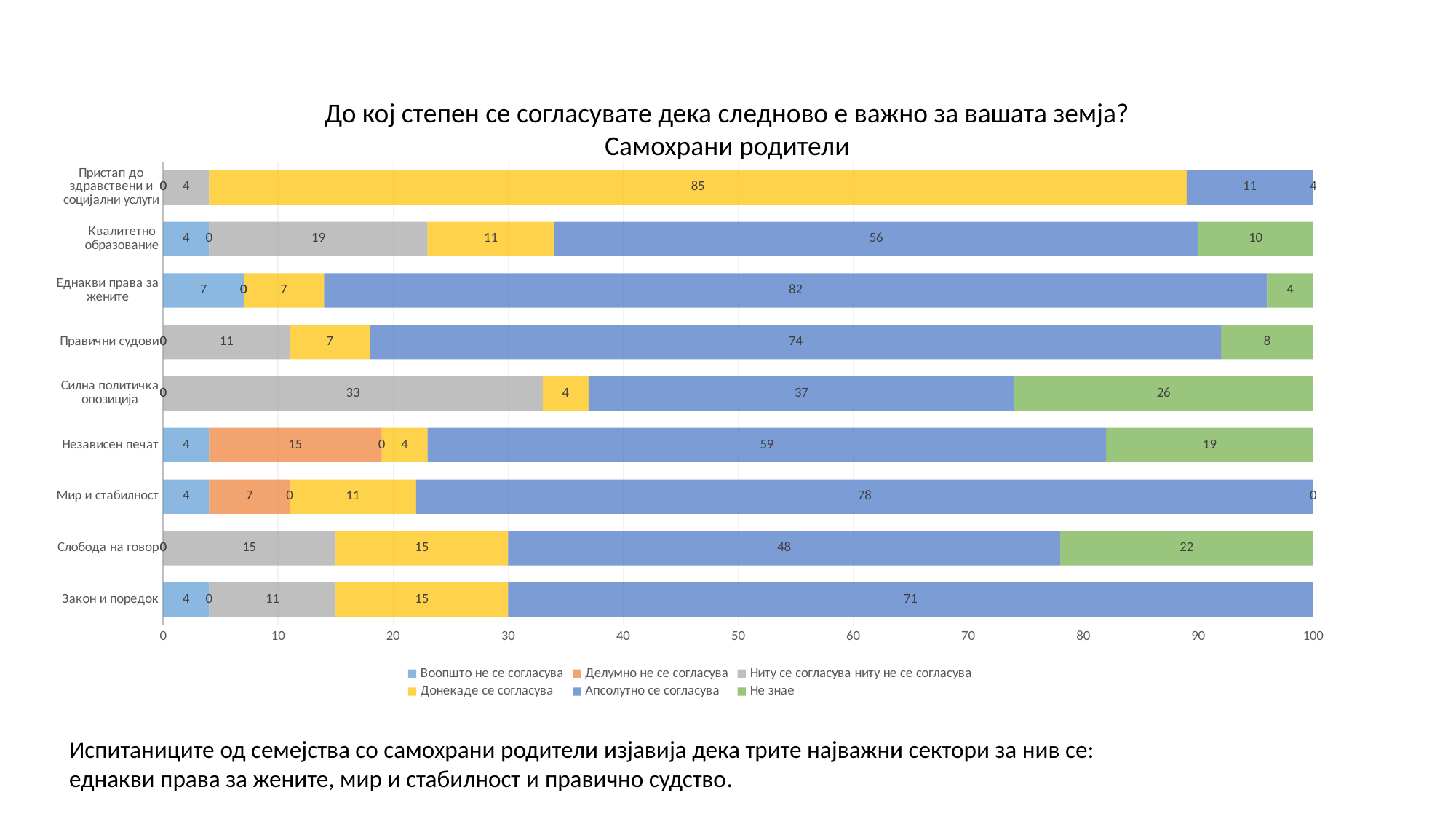
What is the second line of the chart title? Самохрани родители What kind of chart is shown on the slide? Stacked bar chart How many series does the legend list? 6 What is the value of "Не знае" for "Силна политичка опозиција"? 26 What is the value of "Делумно не се согласува" for "Независен печат"? 15 How many categories are plotted on the chart? 9 Which is larger: the "Не знае" value for "Слобода на говор" or for "Независен печат"? Слобода на говор What is the value of "Донекаде се согласува" for "Пристап до здравствени и социјални услуги"? 85 Which category has the highest value for "Апсолутно се согласува"? Еднакви права за жените What is the difference between the "Апсолутно се согласува" values for "Мир и стабилност" and "Слобода на говор"? 30 Which category has the lowest value for "Апсолутно се согласува"? Пристап до здравствени и социјални услуги What is the value of "Апсолутно се согласува" for "Еднакви права за жените"? 82